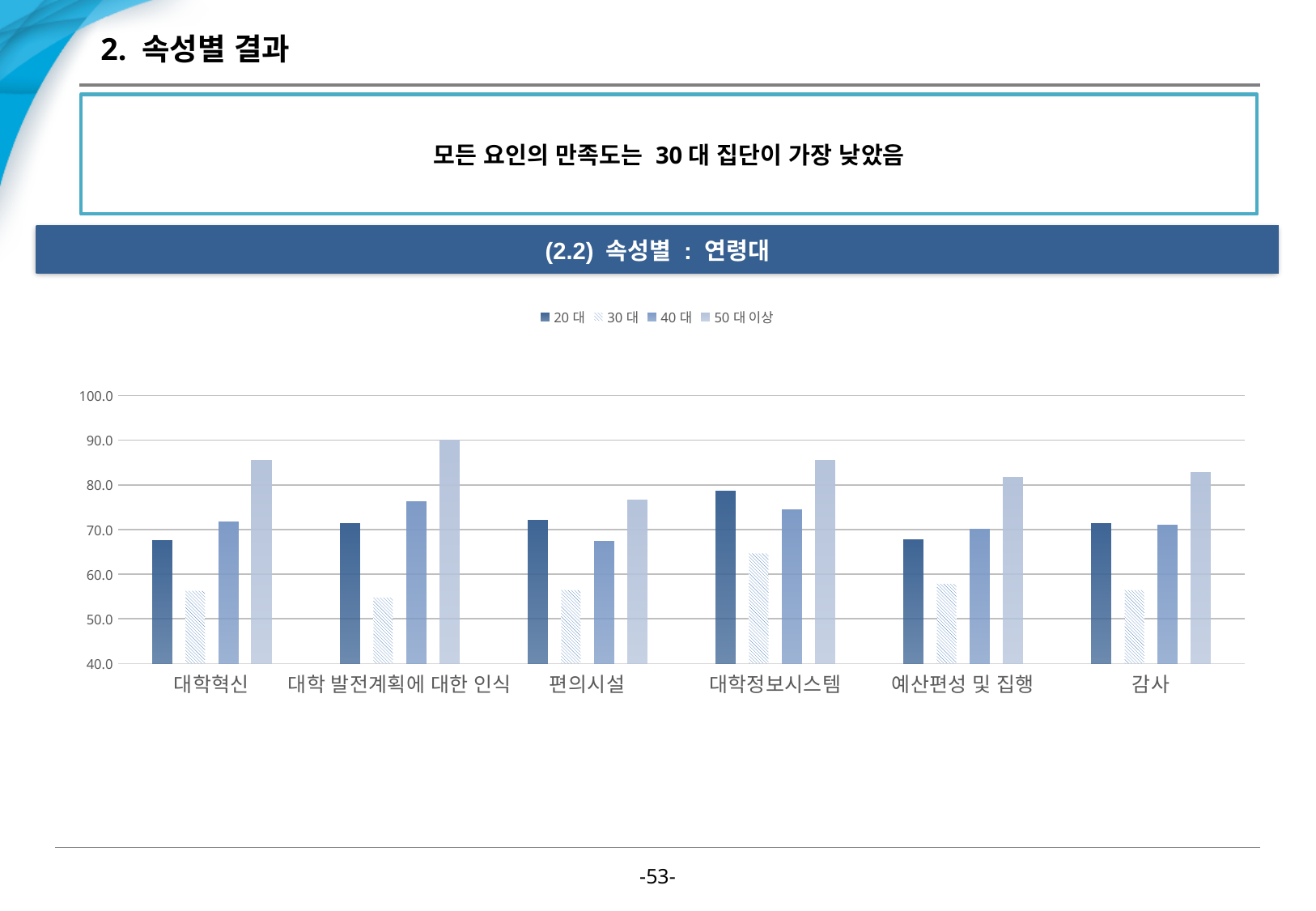
Is the value for 30 대 in the 감사 category greater or less than 60? less How many series does the chart's legend list? 4 Is the value for 30 대 in the 대학정보시스템 category greater or less than 60? greater Which series has the lowest value in the 대학혁신 category? 30 대 What is the last entry listed in the chart's legend? 50 대 이상 In the 편의시설 category, which is larger: the value for 20 대 or the value for 40 대? 20 대 What kind of chart is shown on the slide? bar chart Is the value for 50 대 이상 in the 편의시설 category greater or less than 80? less Which category has the highest value for the 50 대 이상 series? 대학 발전계획에 대한 인식 In the 대학정보시스템 category, which is larger: the value for 20 대 or the value for 40 대? 20 대 Which series has the highest value in the 대학 발전계획에 대한 인식 category? 50 대 이상 How many categories are shown along the x axis of the chart? 6